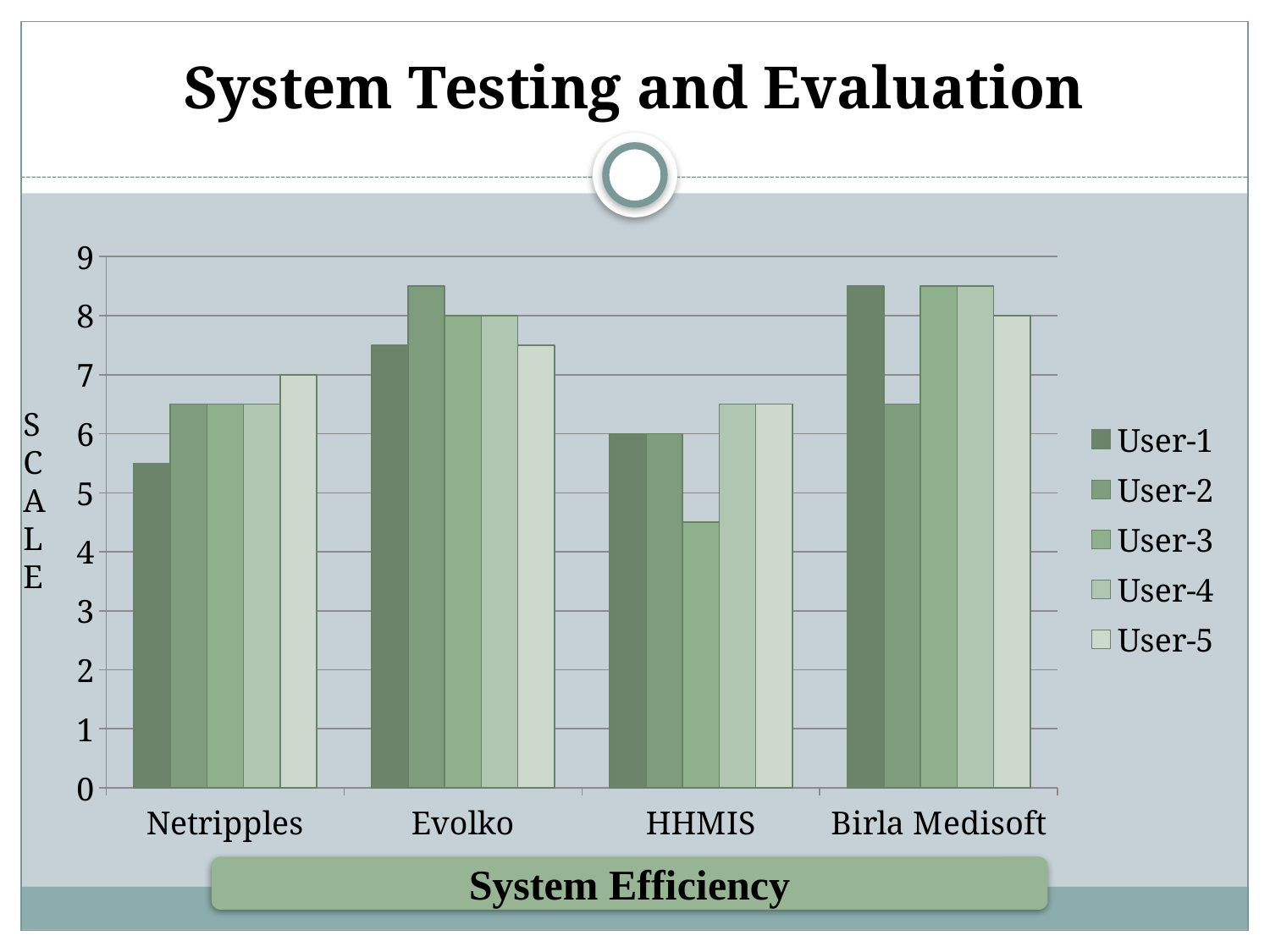
What kind of chart is shown on the slide? bar chart What is the value for User-5 in the Netripples category? 7 What is the value for User-1 in the HHMIS category? 6 How many categories are shown on the x axis? 4 Is the value for User-3 in the HHMIS category greater or less than 5? less Is the value for User-1 in the Birla Medisoft category greater or less than 8? greater What is the label shown on the vertical axis? SCALE How many series does the legend list? 5 Which is larger: the User-1 value for Netripples or the User-1 value for Evolko? Evolko What is the value for User-5 in the Birla Medisoft category? 8 What is the value for User-3 in the Evolko category? 8 Which category has the lowest value for User-3? HHMIS